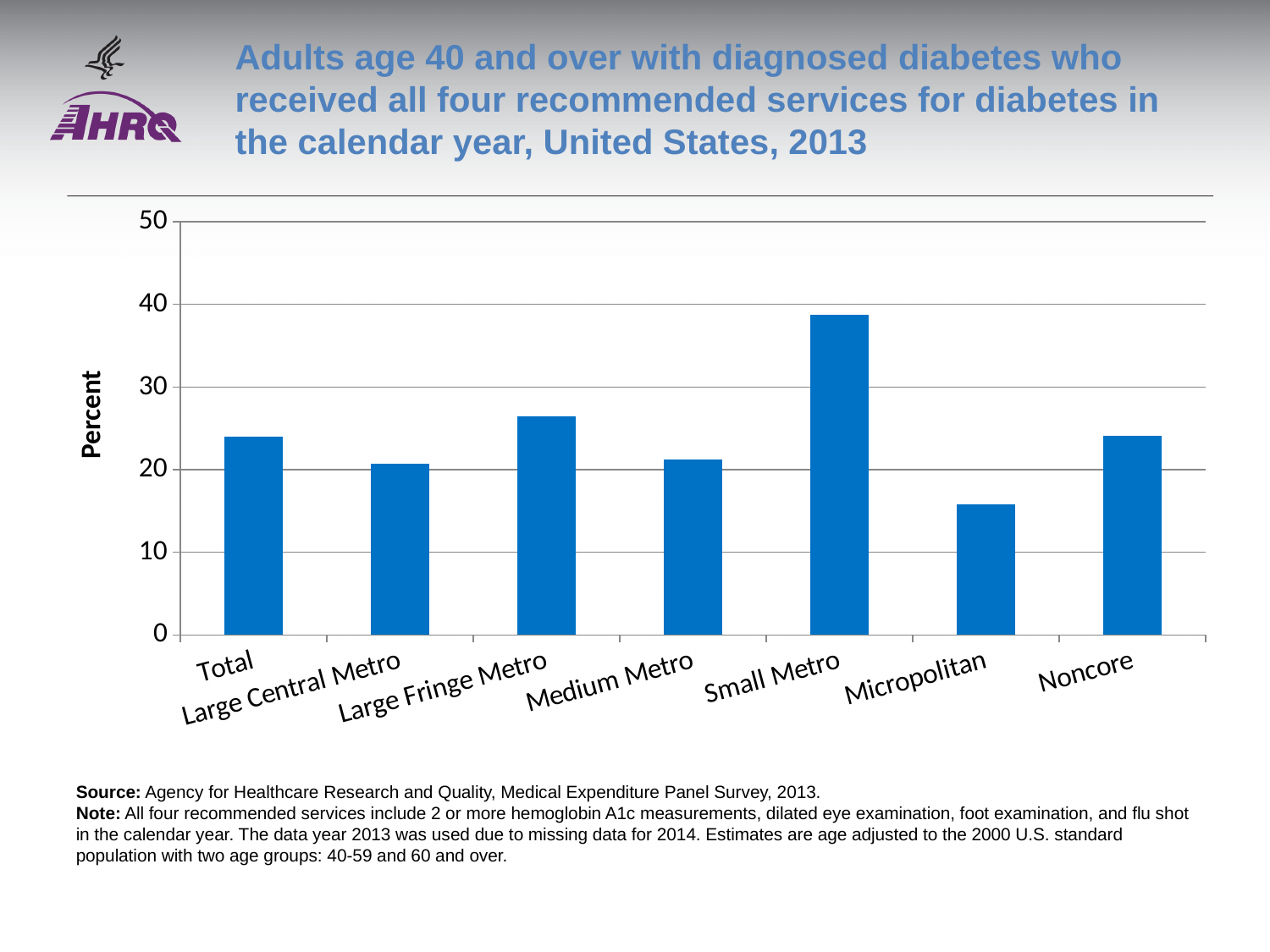
Which is larger, the value for Large Fringe Metro or the value for Large Central Metro? Large Fringe Metro Which is larger, the value for Medium Metro or the value for Small Metro? Small Metro Which category has the highest percent? Small Metro Is the value for Large Fringe Metro greater or less than 30? less Is the value for Small Metro greater or less than 30? greater What is the label on the y axis of the chart? Percent What kind of chart is shown on the slide? Bar chart Is the value for Micropolitan greater or less than 20? less Which category has the lowest percent? Micropolitan How many categories are shown on the x axis of the chart? 7 What is the highest value shown on the y axis of the chart? 50